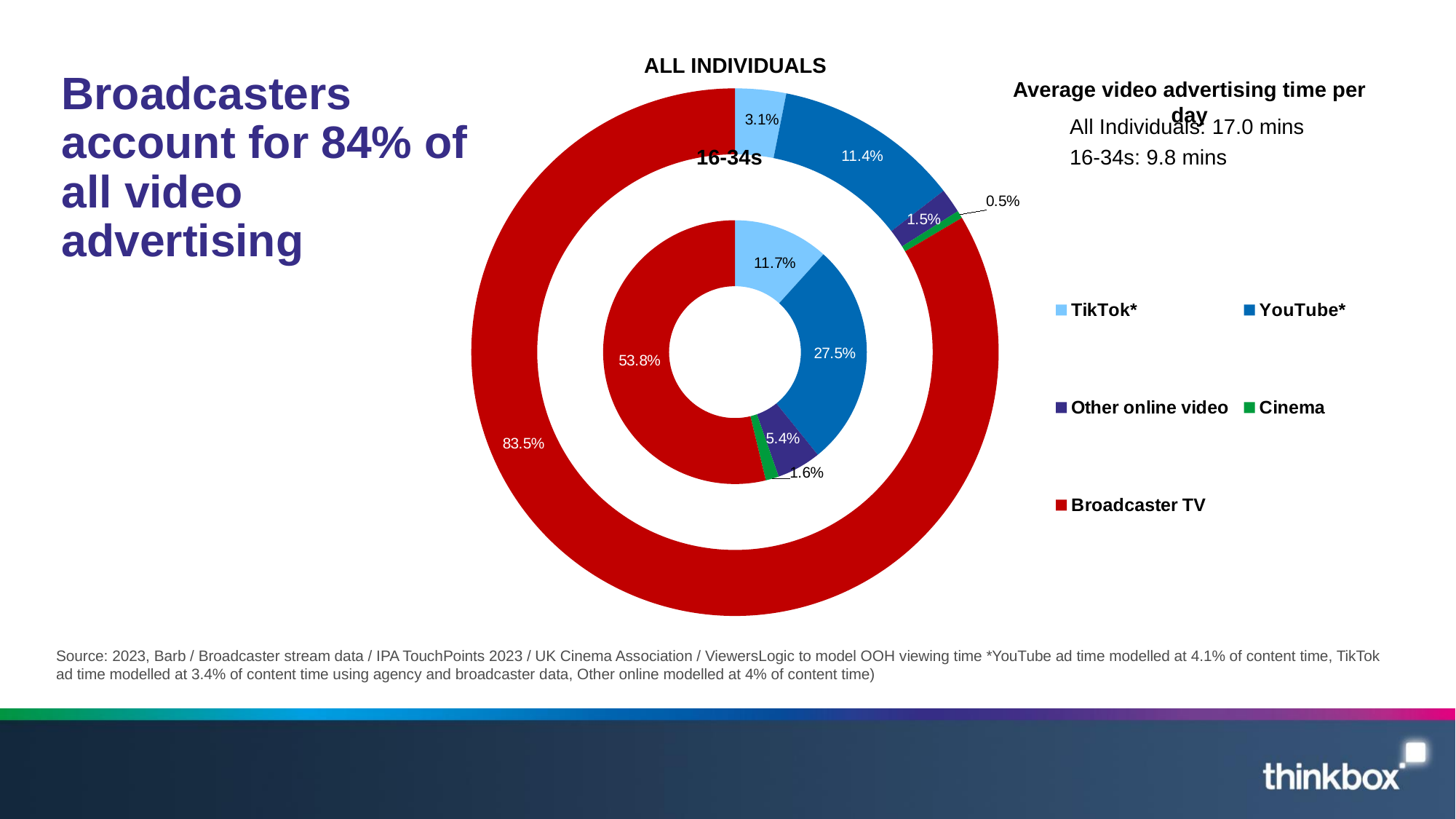
How many series does the legend list? 5 What is the difference between the Broadcaster TV share for ALL INDIVIDUALS (83.5%) and for 16-34s (53.8%)? 29.7% In the outer ring (ALL INDIVIDUALS), what share does Cinema account for? 0.5% In the inner ring (16-34s), which category has the largest share? Broadcaster TV In the outer ring (ALL INDIVIDUALS), what share does Broadcaster TV account for? 83.5% In the inner ring (16-34s), what share does TikTok* account for? 11.7% What kind of chart is shown on the slide? Doughnut chart In the inner ring (16-34s), what share does YouTube* account for? 27.5% According to the text on the slide, what is the average video advertising time per day for 16-34s? 9.8 mins In the outer ring (ALL INDIVIDUALS), which category has the smallest share? Cinema What is the difference between the Other online video share for 16-34s (5.4%) and for ALL INDIVIDUALS (1.5%)? 3.9% Which is larger: the YouTube* share for 16-34s or the YouTube* share for ALL INDIVIDUALS? 16-34s